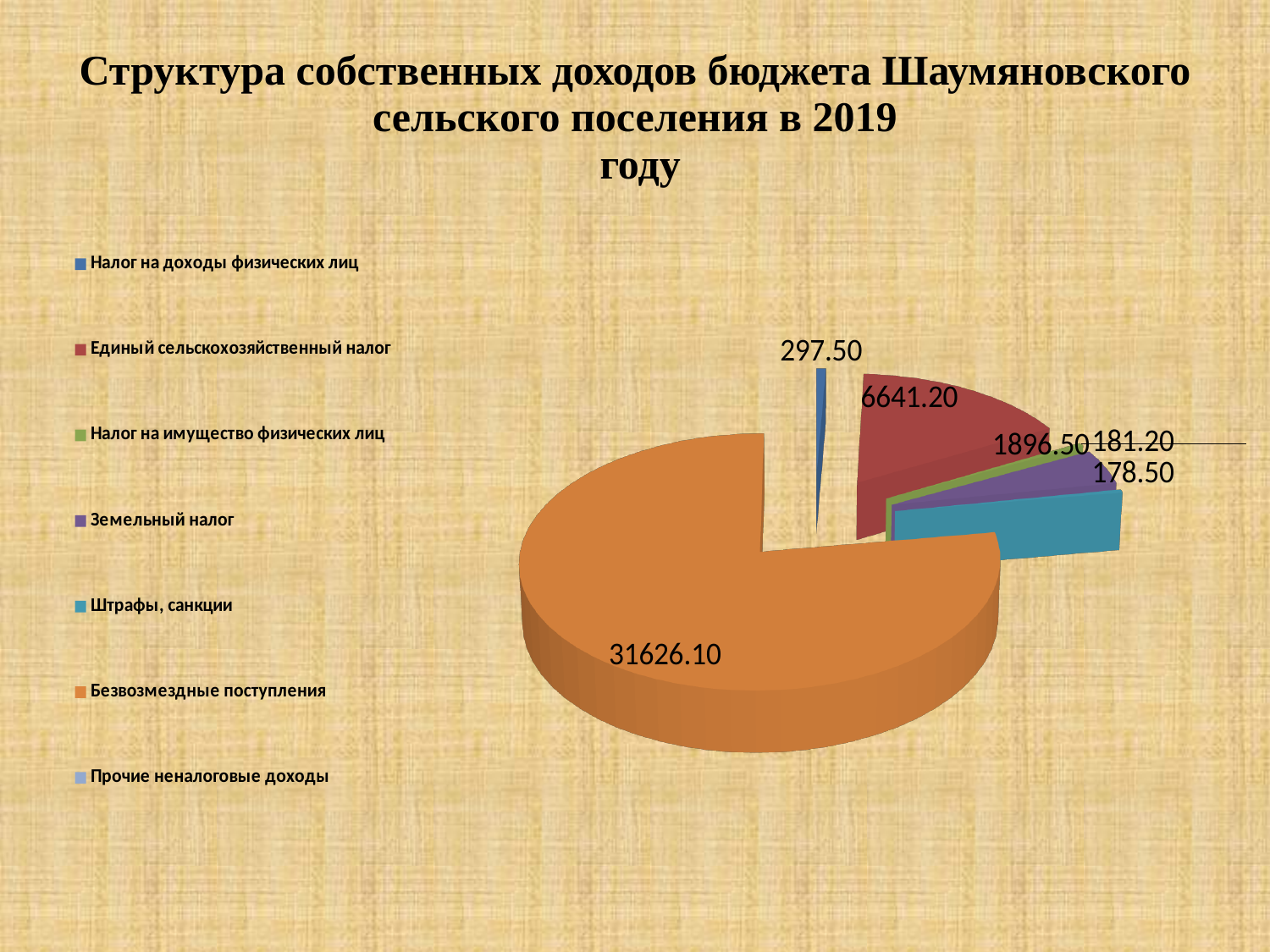
What is the title of the chart on the slide? Структура собственных доходов бюджета Шаумяновского сельского поселения в 2019 году What is the difference between the values for Единый сельскохозяйственный налог and Налог на доходы физических лиц? 6343.70 Which is larger: Единый сельскохозяйственный налог or Налог на доходы физических лиц? Единый сельскохозяйственный налог What is the value shown for Безвозмездные поступления? 31626.10 What colour is the slice for Безвозмездные поступления? Orange Which is larger: Безвозмездные поступления or Единый сельскохозяйственный налог? Безвозмездные поступления What is the value shown for Единый сельскохозяйственный налог? 6641.20 What is the difference between the values for Безвозмездные поступления and Единый сельскохозяйственный налог? 24984.90 How many categories does the legend of the pie chart list? 7 What is the value shown for Налог на доходы физических лиц? 297.50 Which category has the largest slice of the pie? Безвозмездные поступления What kind of chart is shown on the slide? Pie chart